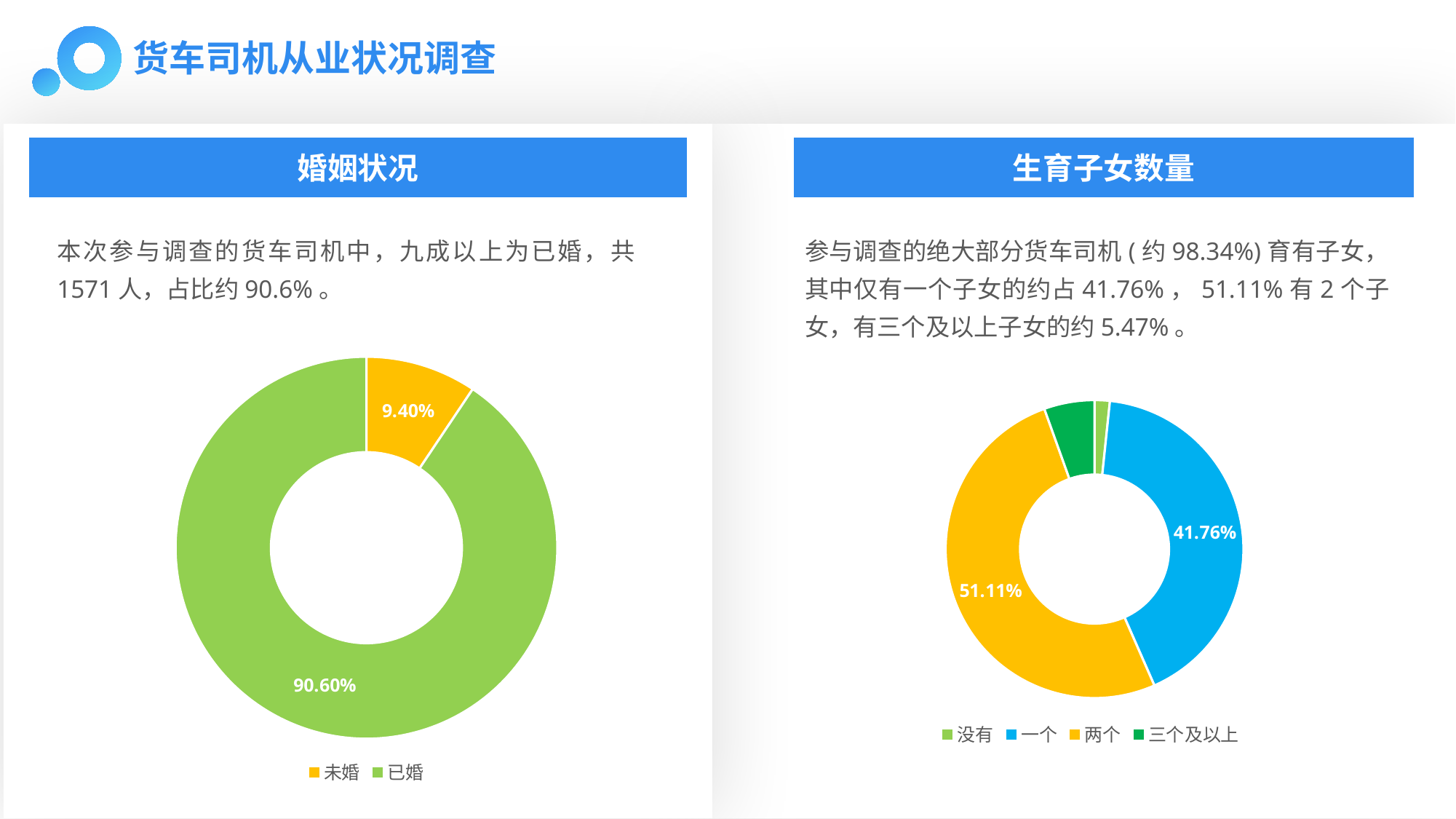
In the 生育子女数量 chart, what percentage is shown for 两个? 51.11% In the 生育子女数量 chart, what percentage is shown for 一个? 41.76% In the 婚姻状况 chart, what percentage is shown for 未婚? 9.40% What kind of chart is used in the 婚姻状况 panel? Donut (pie) chart In the 生育子女数量 chart, which category has the smallest share? 没有 In the 生育子女数量 chart, which category has the largest share? 两个 In the 婚姻状况 chart, which category has the larger share? 已婚 In the 婚姻状况 chart, what is the difference between the 已婚 and 未婚 shares? 81.20% In the 生育子女数量 chart, which colour represents 一个? Blue In the 婚姻状况 chart, what percentage is shown for 已婚? 90.60% In the 生育子女数量 chart, how many categories does the legend list? 4 How many entries does the legend of the 婚姻状况 chart list? 2